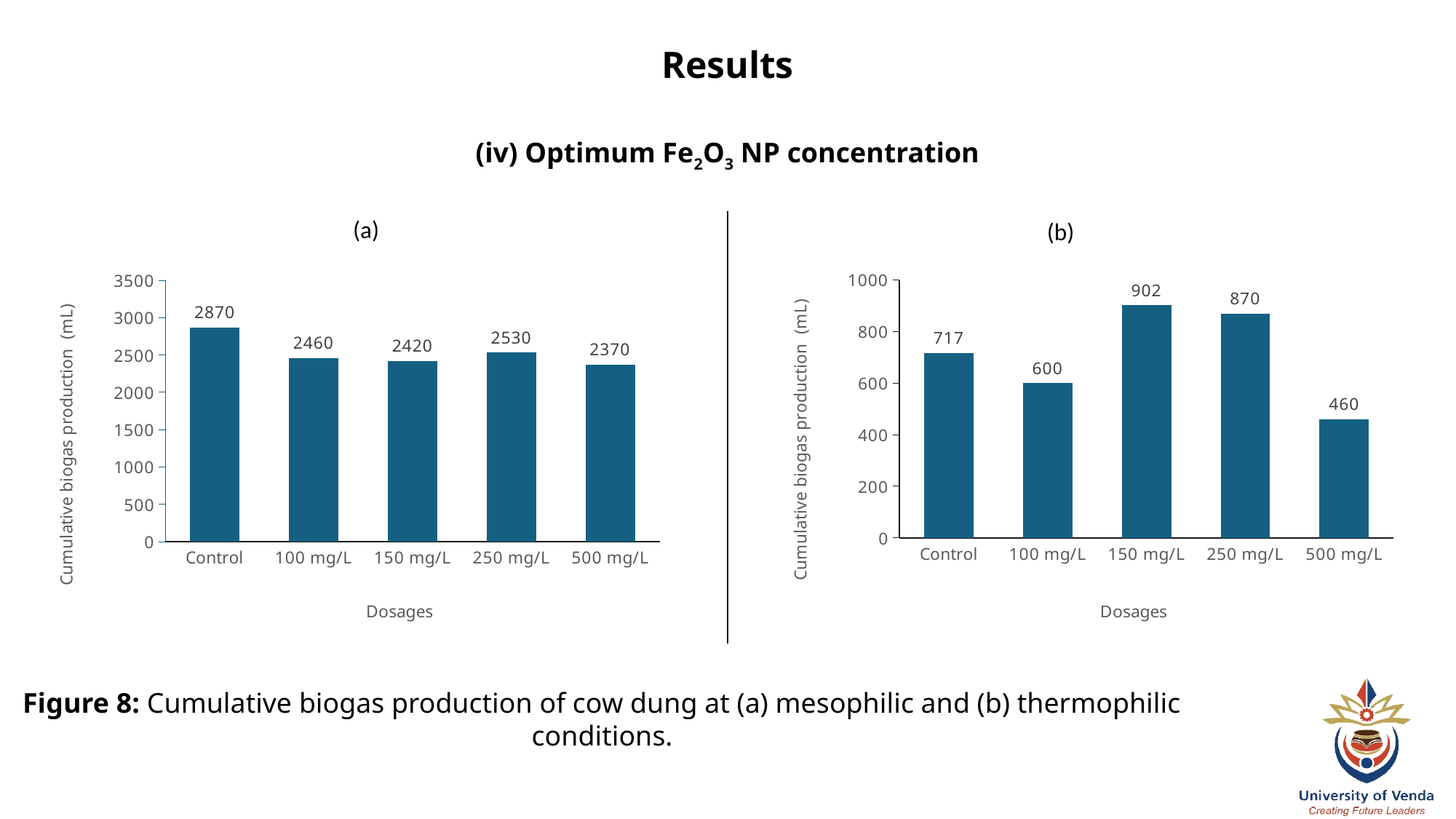
In chart (b) on the right, what is the difference between the 150 mg/L value and the 100 mg/L value? 302 What kind of chart is chart (b) on the right? bar chart How many dosage categories are shown in chart (a) on the left? 5 In chart (b) on the right, is the value for 500 mg/L greater or less than 600? less In chart (b) on the right, which dosage has the lowest cumulative biogas production? 500 mg/L In chart (b) on the right, what is the cumulative biogas production at 150 mg/L? 902 In chart (a) on the left, what is the difference between the Control value and the 500 mg/L value? 500 In chart (a) on the left, what is the cumulative biogas production for the Control dosage? 2870 What is the y-axis label of chart (a) on the left? Cumulative biogas production (mL) In chart (a) on the left, which dosage has the lowest cumulative biogas production? 500 mg/L In chart (b) on the right, which dosage has the highest cumulative biogas production? 150 mg/L In chart (a) on the left, which is larger: the value at 100 mg/L or the value at 250 mg/L? 250 mg/L